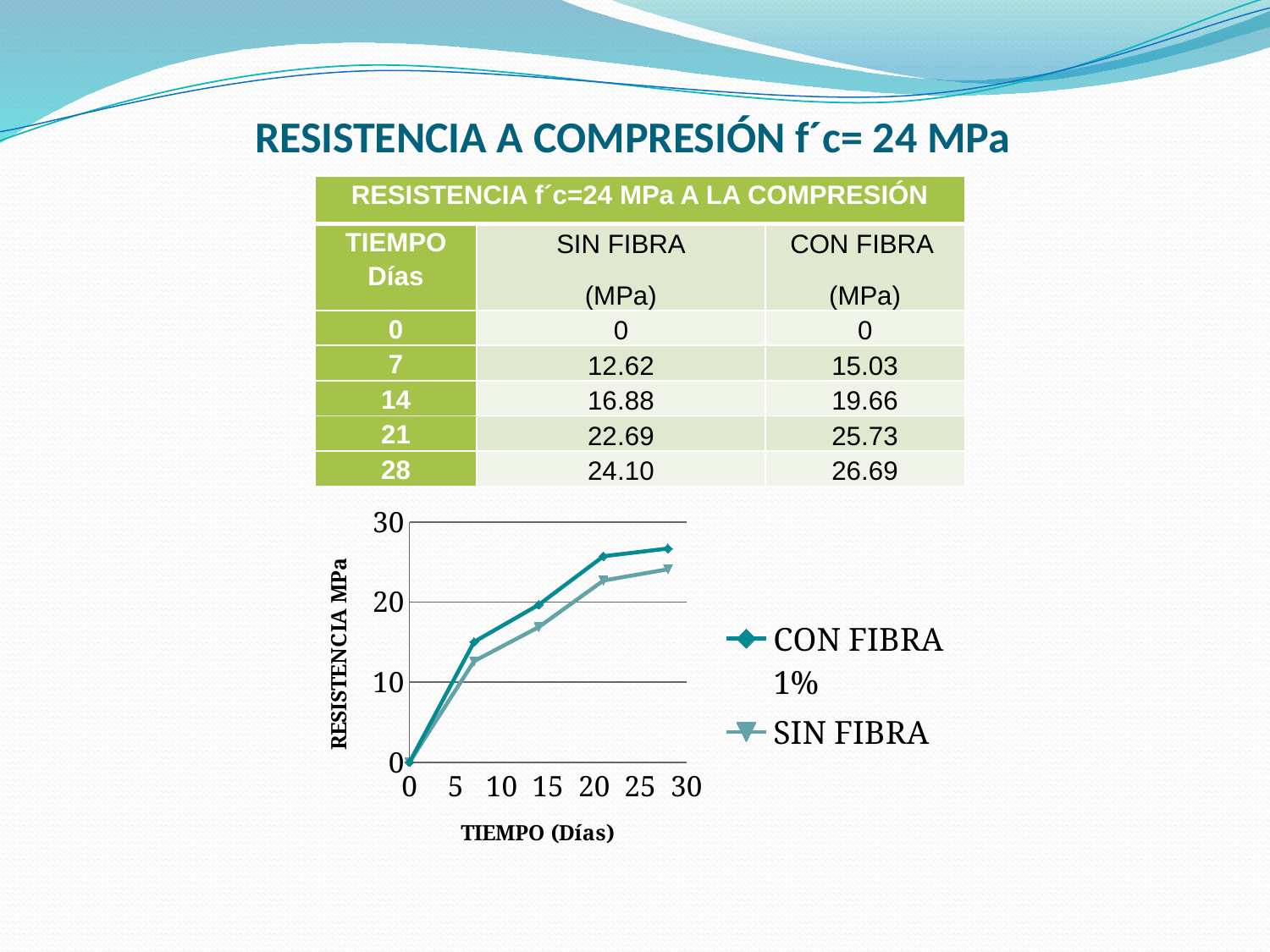
According to the table on the slide, what is the SIN FIBRA resistance at 28 days? 24.10 What is the label of the chart's vertical axis? RESISTENCIA MPa How many data points are plotted for each series in the chart? 5 According to the table on the slide, what is the CON FIBRA resistance at 14 days? 19.66 Using the table values, what is the difference between CON FIBRA and SIN FIBRA at 28 days? 2.59 Do the values for CON FIBRA rise or fall as time (days) increases along the x axis? rise What are the two series named in the chart legend? CON FIBRA 1% and SIN FIBRA Is the value for SIN FIBRA at 7 days greater or less than 20? less What kind of chart is shown on the slide? line chart At 28 days, which series has the higher value, CON FIBRA or SIN FIBRA? CON FIBRA Is the value for CON FIBRA at 21 days greater or less than 20? greater How many series does the chart legend list? 2